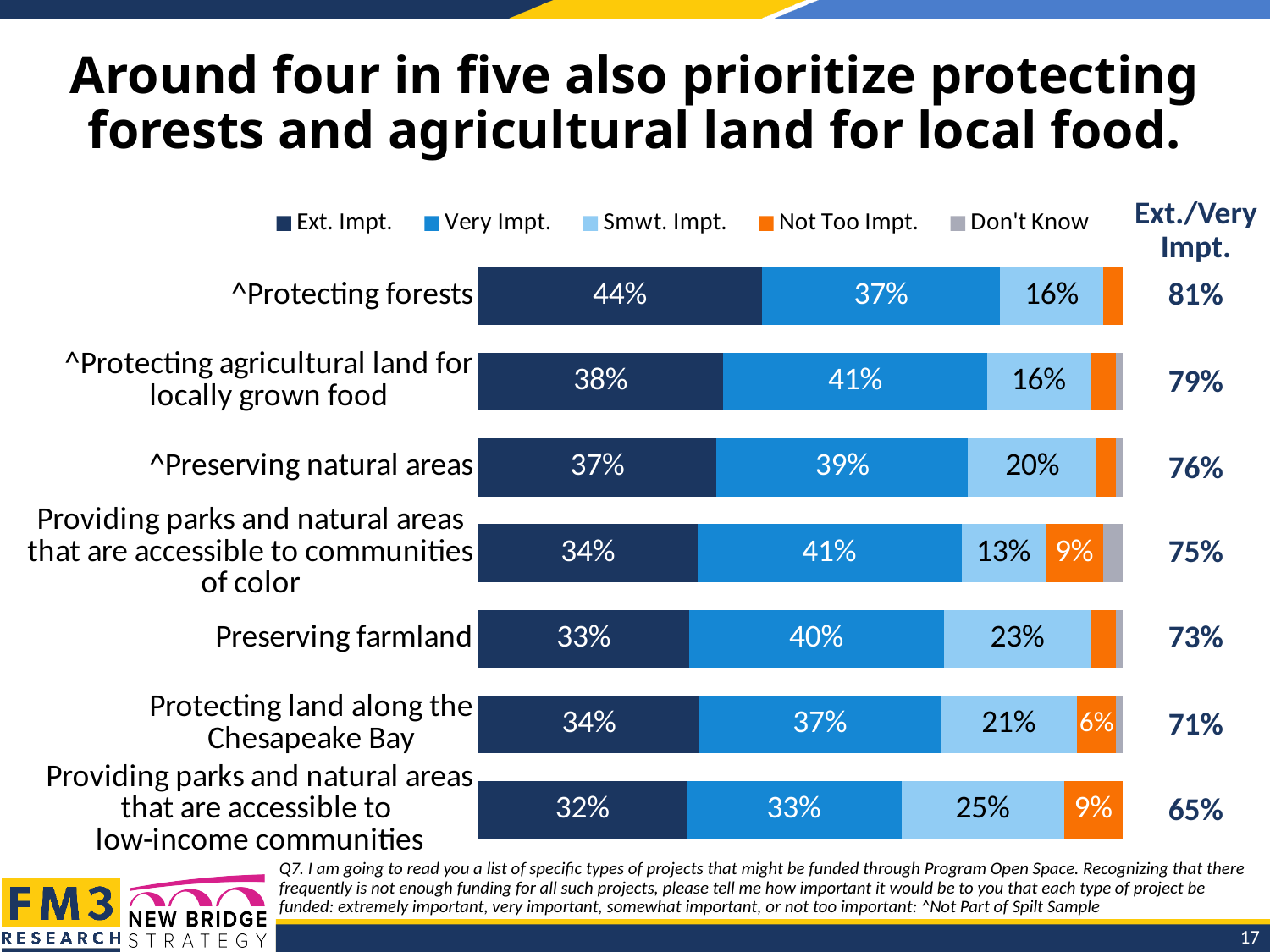
What is the Ext./Very Impt. combined value for 'Preserving farmland'? 73% Which category has the highest Ext. Impt. value? ^Protecting forests Which has a larger Ext. Impt. value: 'Protecting forests' or 'Protecting agricultural land for locally grown food'? ^Protecting forests What is the Very Impt. value for 'Protecting agricultural land for locally grown food'? 41% How many series does the legend list? 5 How many project types (categories) are shown in the chart? 7 Which category has the highest Smwt. Impt. value? Providing parks and natural areas that are accessible to low-income communities Which category has the lowest Ext./Very Impt. combined value? Providing parks and natural areas that are accessible to low-income communities What percentage rated 'Protecting forests' as extremely important (Ext. Impt.)? 44% What is the difference in percentage points between the Ext./Very Impt. value for 'Protecting forests' and for 'Providing parks and natural areas that are accessible to low-income communities'? 16 percentage points What is the Not Too Impt. value for 'Protecting land along the Chesapeake Bay'? 6% What kind of chart is shown on the slide? Stacked bar chart